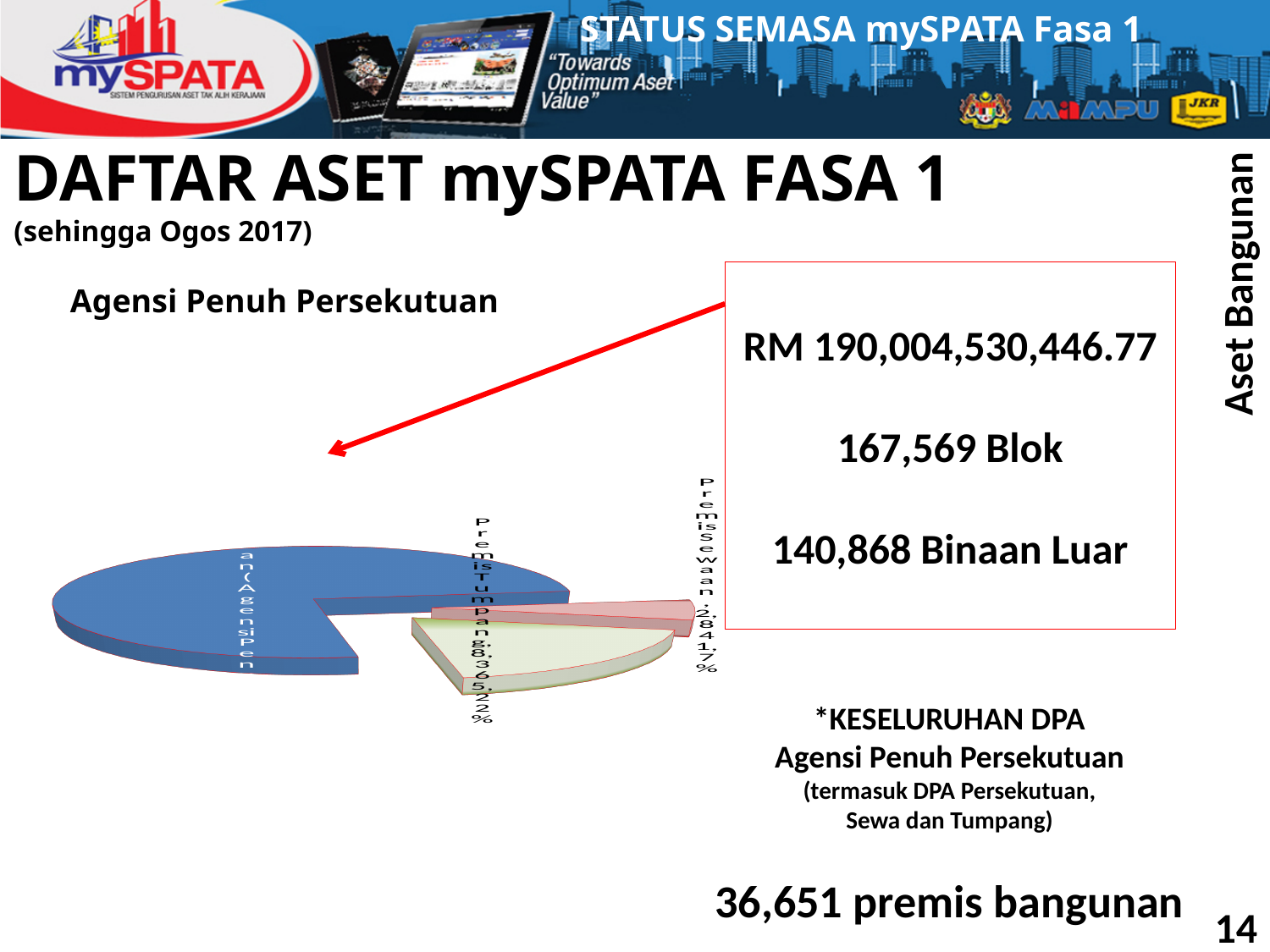
Which slice of the pie chart is the smallest? Premis Sewaan What share of the pie does Premis Sewaan represent? 7% What is the value shown for Premis Sewaan in the pie chart? 2,841 What colour is the Premis Sewaan slice in the pie chart? pink What kind of chart is shown on the slide? pie chart What is the heading printed above the pie chart? Agensi Penuh Persekutuan How many slices does the pie chart have? 3